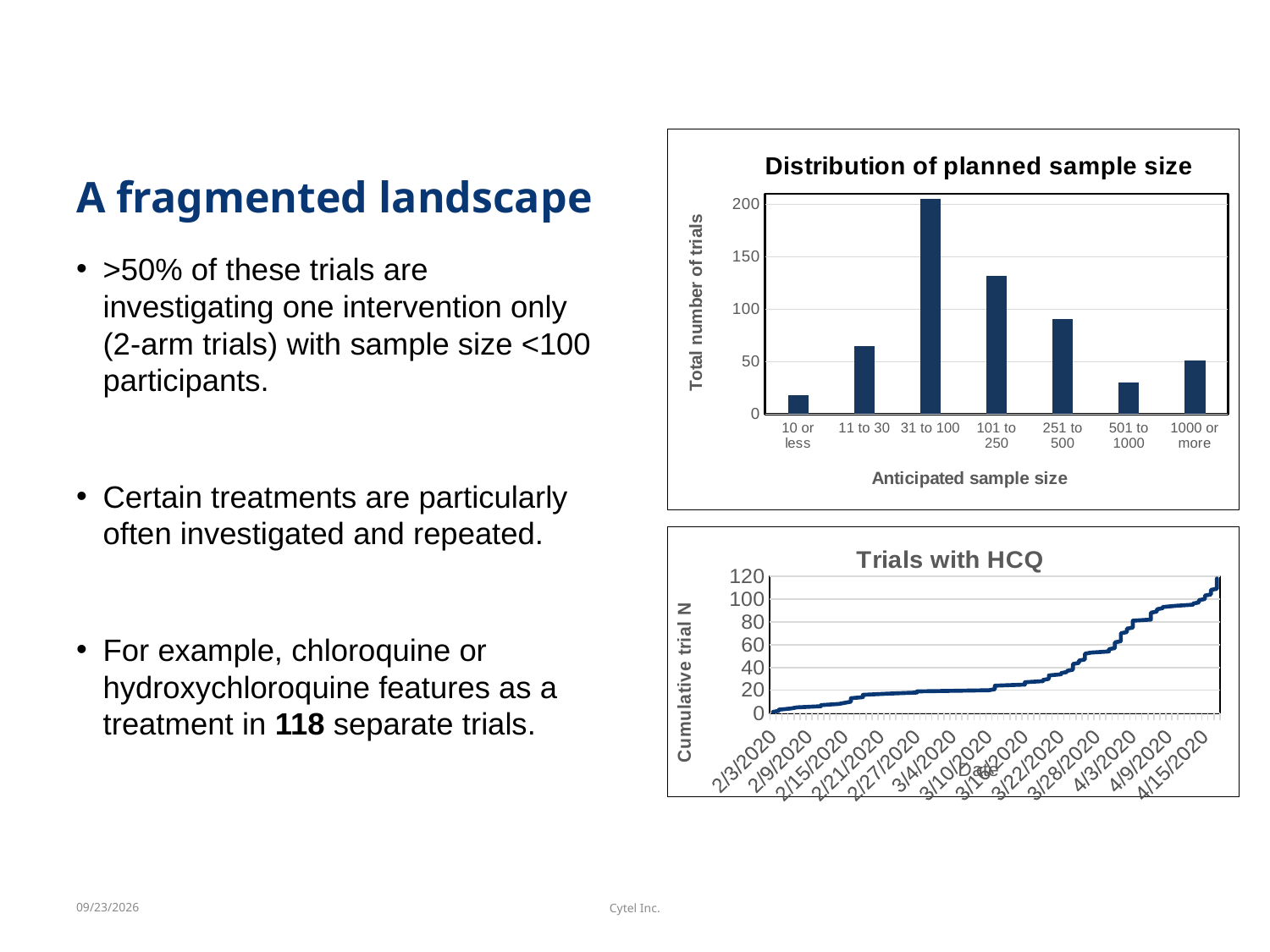
In the 'Distribution of planned sample size' chart, which has more trials: '251 to 500' or '1000 or more'? 251 to 500 In the 'Distribution of planned sample size' chart, is the value for '501 to 1000' greater or less than 50? less What kind of chart is the 'Trials with HCQ' chart? line chart What is the y-axis label of the 'Distribution of planned sample size' chart? Total number of trials In the 'Distribution of planned sample size' chart, is the value for '101 to 250' greater or less than 100? greater In the 'Trials with HCQ' chart, does the cumulative trial N rise or fall over time along the x axis? rise In the 'Trials with HCQ' chart, is the cumulative trial N on 3/4/2020 greater or less than 40? less In the 'Distribution of planned sample size' chart, which anticipated sample size category has the lowest total number of trials? 10 or less What kind of chart is the 'Distribution of planned sample size' chart? bar chart In the 'Distribution of planned sample size' chart, how many sample size categories are shown on the x axis? 7 In the 'Distribution of planned sample size' chart, which anticipated sample size category has the highest total number of trials? 31 to 100